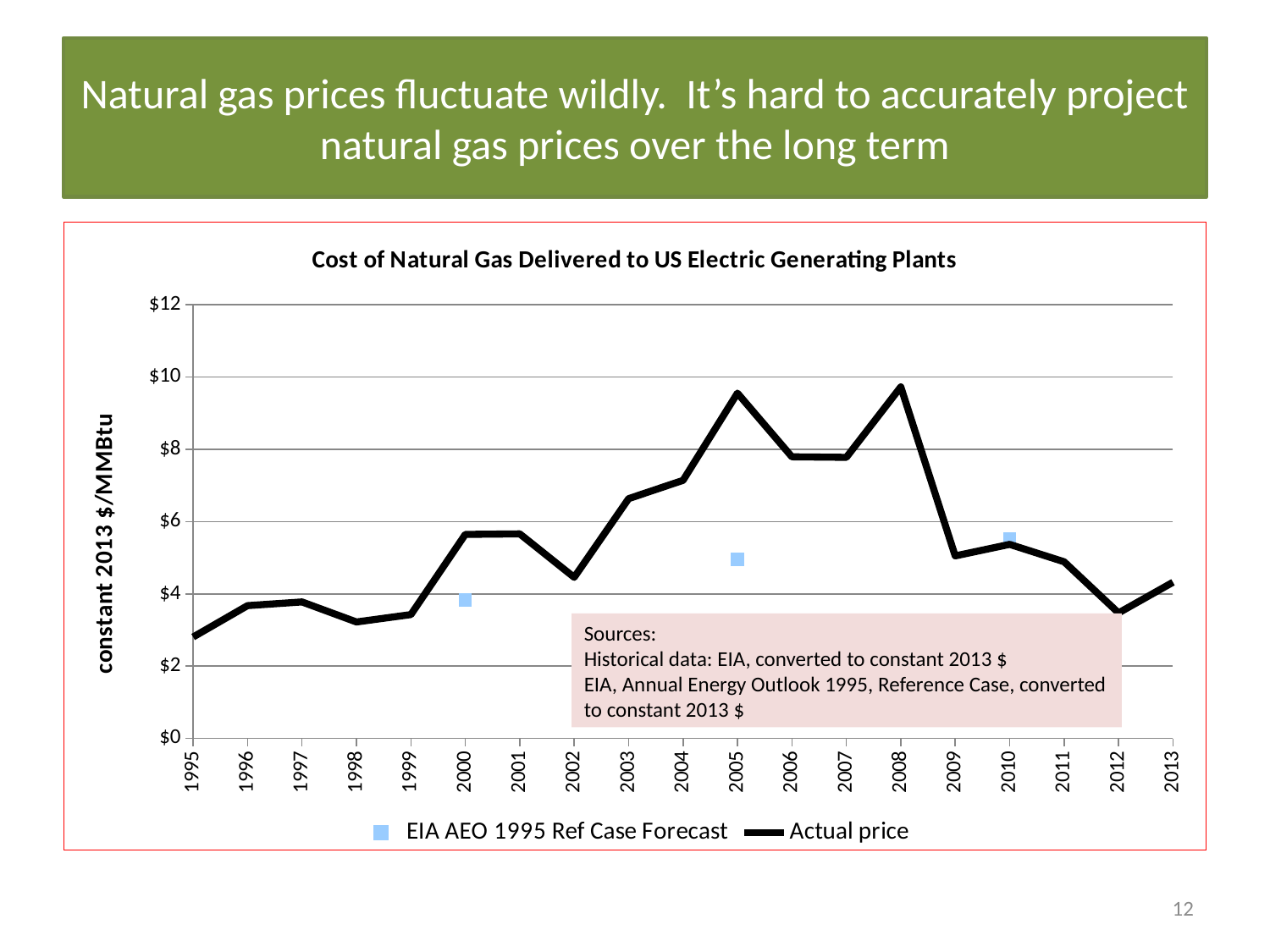
Is the actual price in 2012 greater or less than $4? less What is the label of the y axis? constant 2013 $/MMBtu Which is larger, the actual price in 2005 or the actual price in 2009? 2005 In 2005, which is larger, the EIA AEO 1995 Ref Case Forecast or the actual price? Actual price Is the actual price in 2008 greater or less than $8? greater Does the actual price rise or fall from 2008 to 2012? fall Is the actual price in 2003 greater or less than $6? greater What is the title of the chart? Cost of Natural Gas Delivered to US Electric Generating Plants How many series does the chart legend list? 2 How many years are shown along the x axis? 19 What kind of chart is shown on the slide? line chart Which year has the lowest actual price? 1995